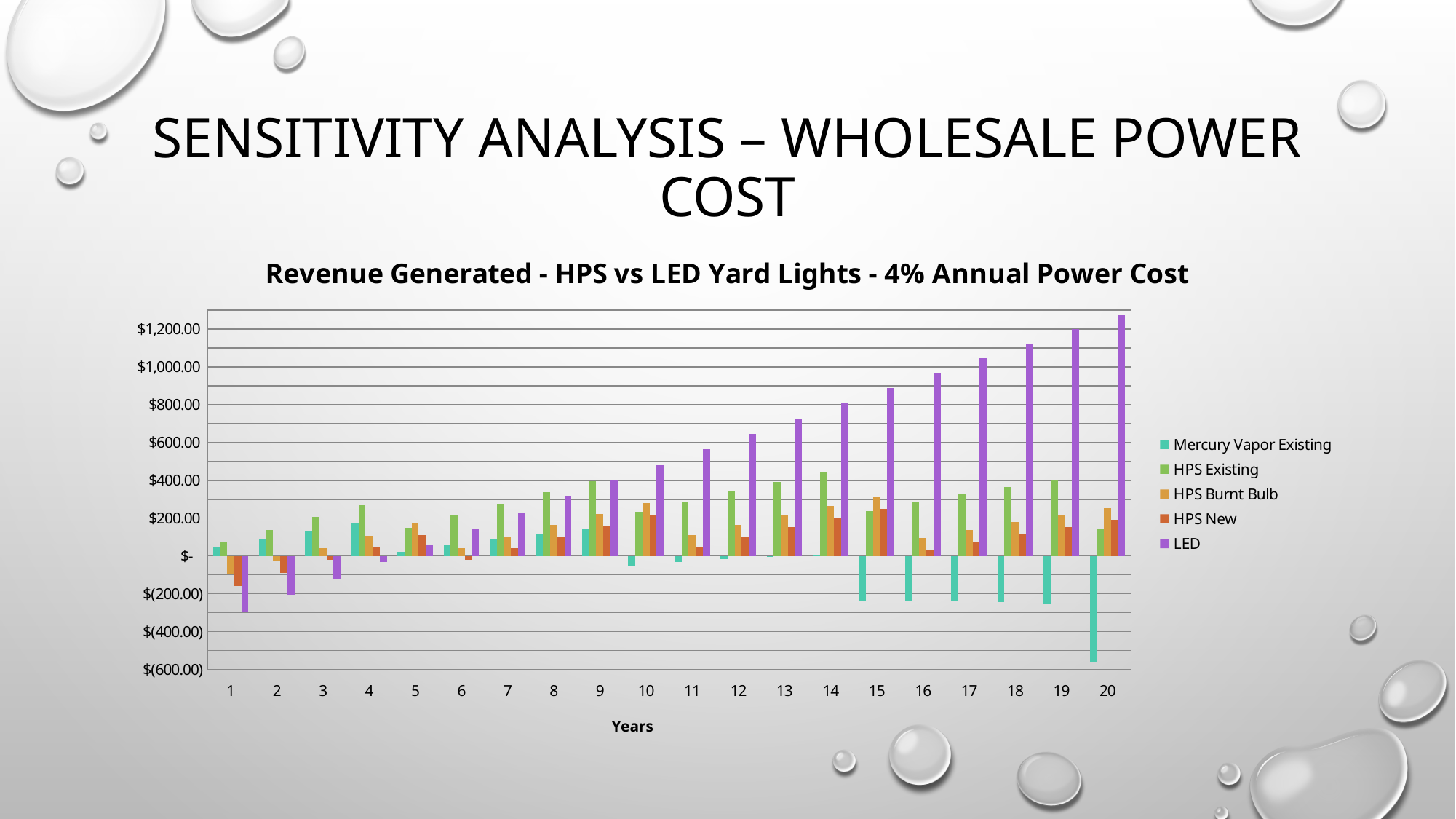
In which year is the LED value lowest? 1 Is the LED value for year 20 greater or less than $1,200.00? greater Is the Mercury Vapor Existing value for year 20 greater or less than $(400.00)? less Which series has the highest value in year 20? LED Do the LED values rise or fall from year 1 to year 20? Rise What kind of chart is shown on the slide? Bar chart How many years are shown along the x axis? 20 How many series does the legend list? 5 What is the title of the chart? Revenue Generated - HPS vs LED Yard Lights - 4% Annual Power Cost In which year is the LED value highest? 20 Which series has the lowest value in year 20? Mercury Vapor Existing In year 1, which is larger, HPS Existing or LED? HPS Existing